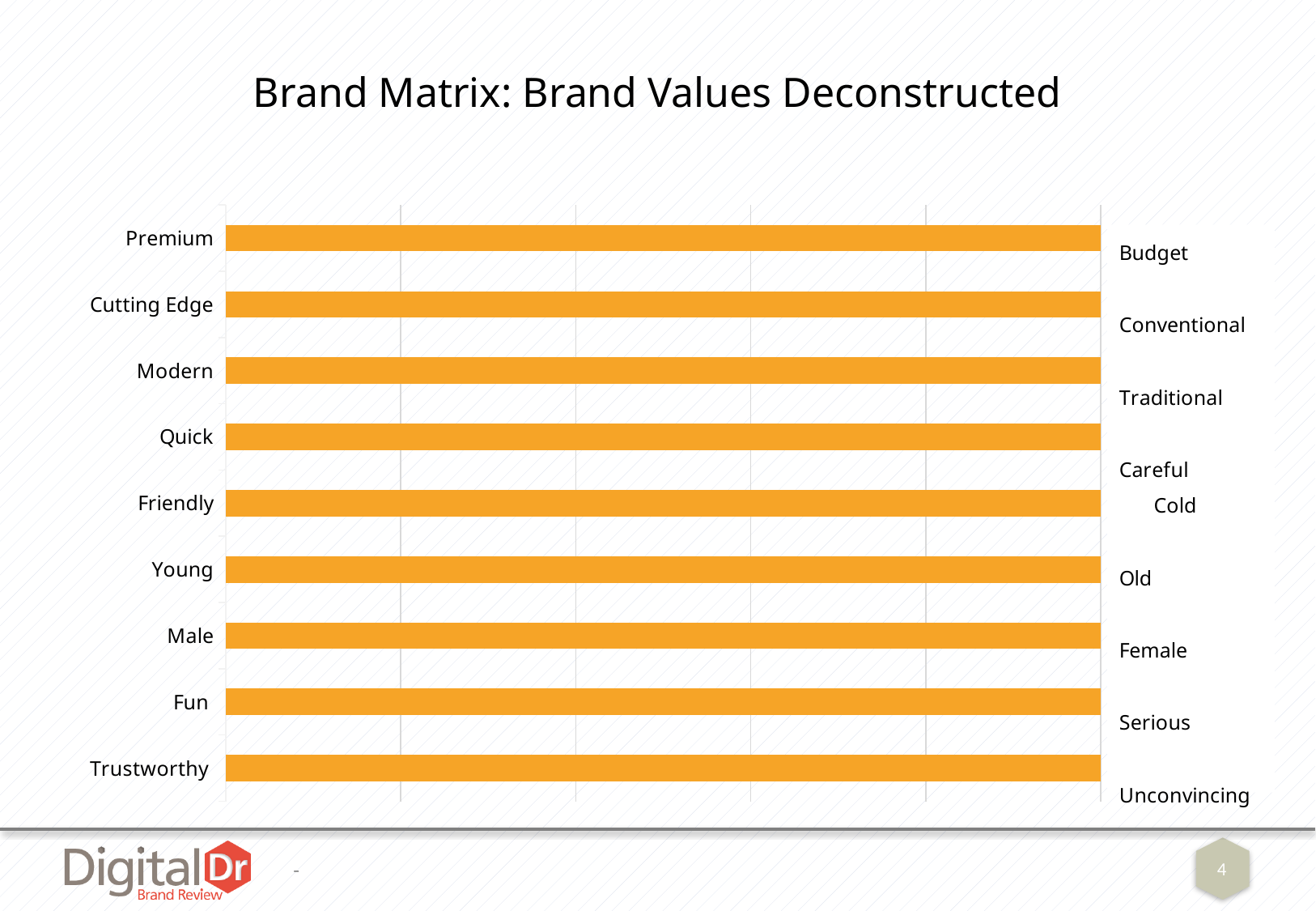
How many categories (bars) does the chart show? 9 What colour are the bars in the chart? orange What is the title of the slide containing the chart? Brand Matrix: Brand Values Deconstructed What kind of chart is shown on the slide? bar chart Are the bars for Premium and Trustworthy the same length? yes